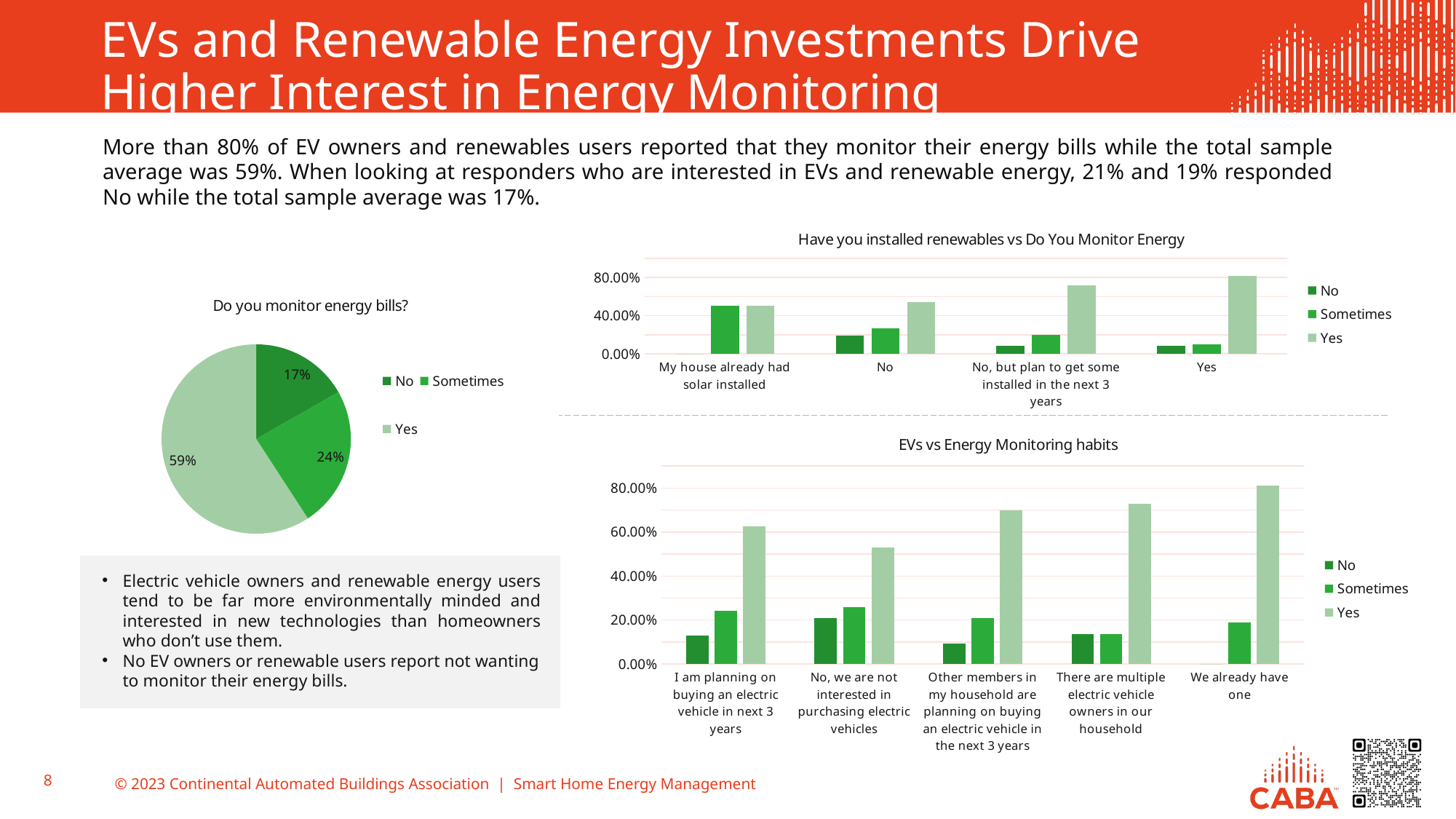
In the chart 'EVs vs Energy Monitoring habits', is the No value for 'I am planning on buying an electric vehicle in next 3 years' greater or less than 20.00%? less In the pie chart 'Do you monitor energy bills?', what share of respondents answered Yes? 59% In the chart 'Have you installed renewables vs Do You Monitor Energy', how many categories are shown on the x axis? 4 In the pie chart 'Do you monitor energy bills?', what share of respondents answered No? 17% How many series does the legend of the chart 'EVs vs Energy Monitoring habits' list? 3 In the chart 'Have you installed renewables vs Do You Monitor Energy', is the Yes value for the 'Yes' category greater or less than 40.00%? greater In the pie chart 'Do you monitor energy bills?', which response has the largest slice? Yes In the pie chart 'Do you monitor energy bills?', which response has the smallest slice? No In the chart 'EVs vs Energy Monitoring habits', which category has the highest Yes bar? We already have one What kind of chart is 'Do you monitor energy bills?' Pie chart In the chart 'Have you installed renewables vs Do You Monitor Energy', for the 'No' category, which is larger: the No bar or the Yes bar? Yes In the pie chart 'Do you monitor energy bills?', how many percentage points larger is the Yes slice than the No slice? 42%